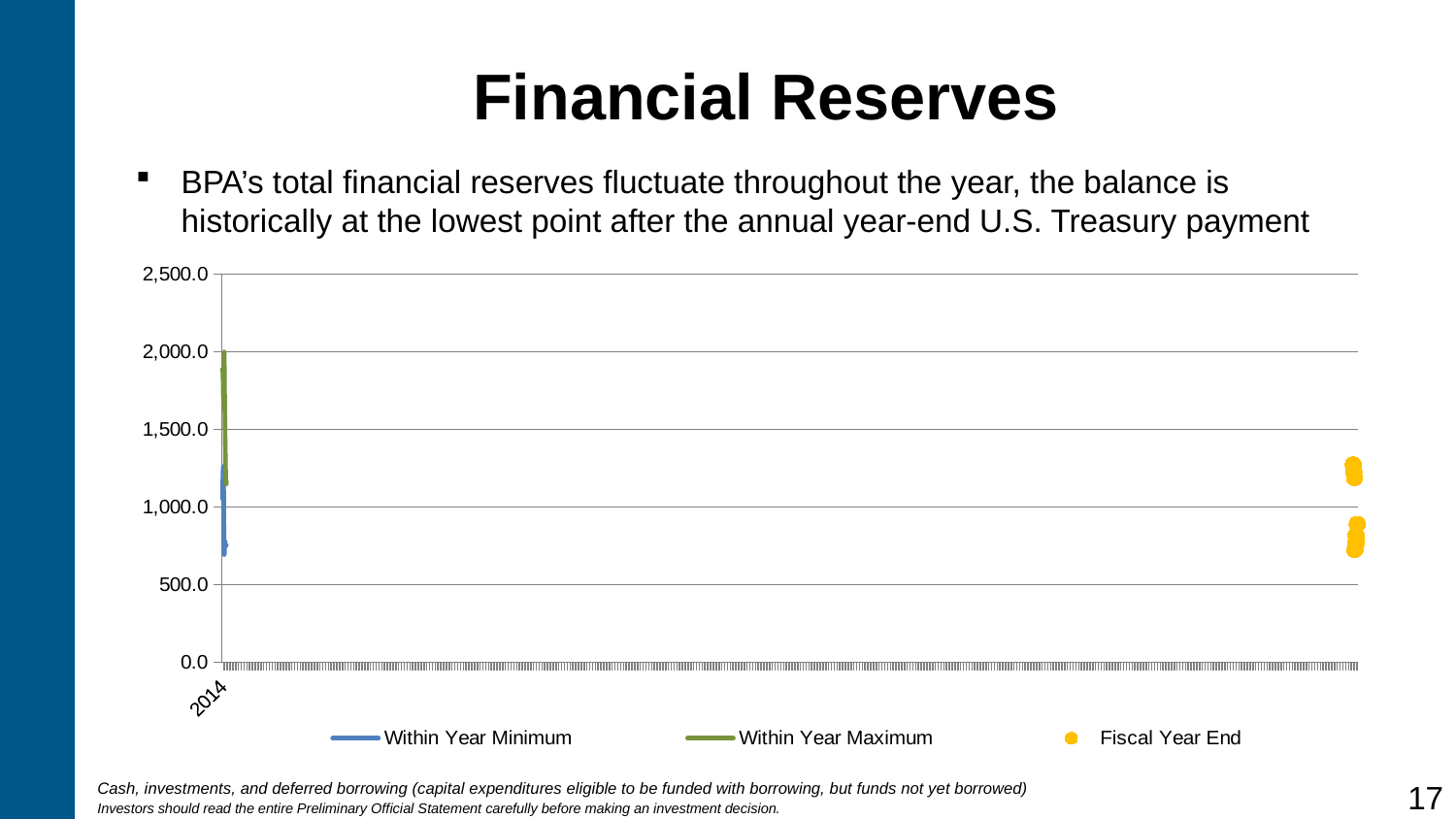
What kind of chart is shown on the slide? Line chart Which series in the chart is drawn in green? Within Year Maximum Is the Within Year Minimum line greater or less than 1,500.0 at every point? less Which series reaches a higher value on the chart, Within Year Maximum or Within Year Minimum? Within Year Maximum Are all the Fiscal Year End points greater or less than 1,500.0? less What are the three series named in the chart legend? Within Year Minimum, Within Year Maximum, Fiscal Year End What is the only year label readable on the chart's horizontal axis? 2014 How many series does the chart legend list? 3 Are all the Fiscal Year End points greater or less than 500.0? greater